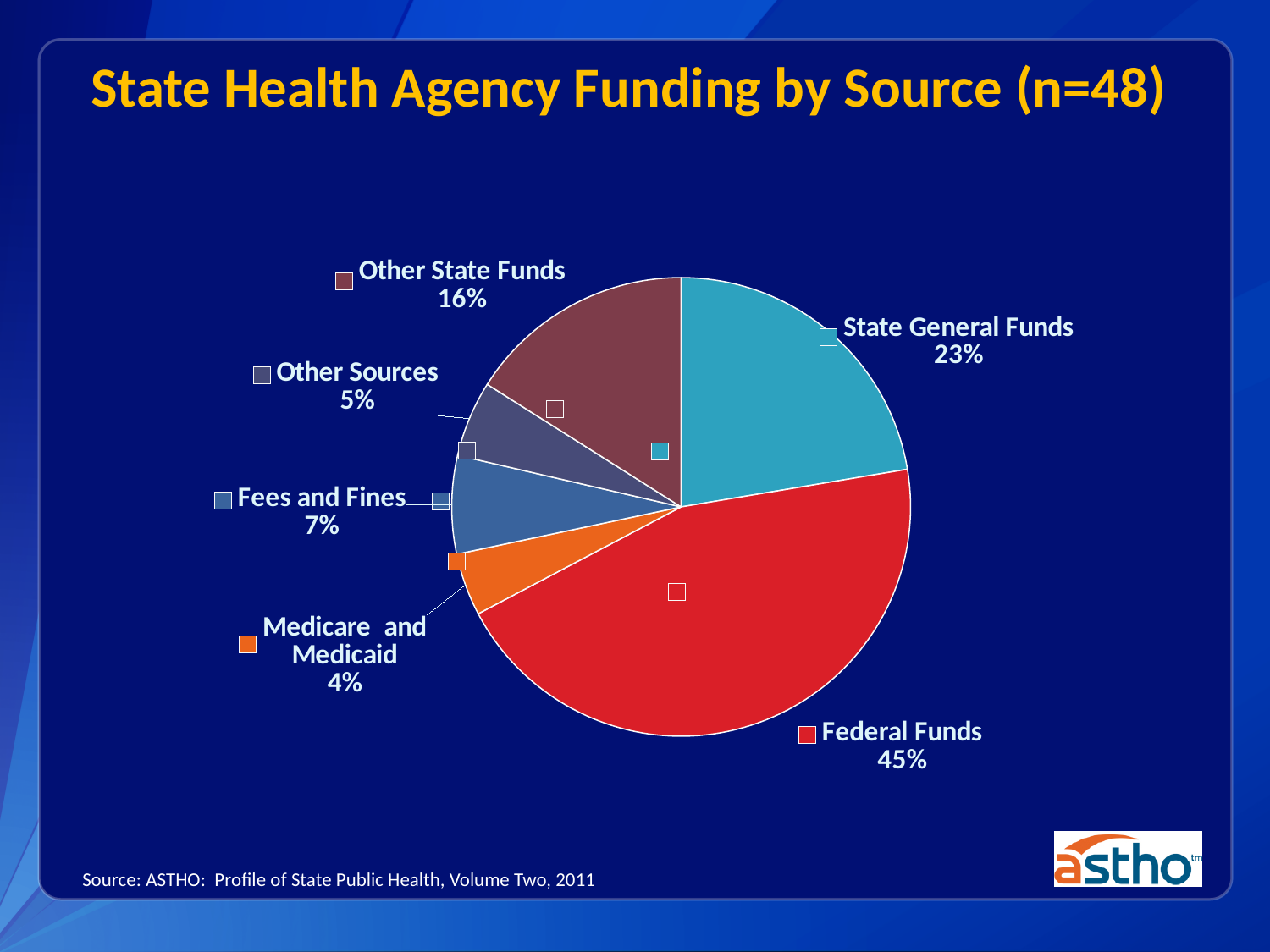
What percentage of funding comes from State General Funds? 23% How many percentage points larger is the Federal Funds share than the State General Funds share? 22 What type of chart is shown on the slide? Pie chart How many funding sources are shown in the pie chart? 6 Which is larger, the share for Fees and Fines or the share for Other Sources? Fees and Fines What is the title of the chart? State Health Agency Funding by Source (n=48) What share of funding is from Medicare and Medicaid? 4% What is the combined share of Other State Funds and Other Sources? 21% Which funding source accounts for the smallest share of the pie? Medicare and Medicaid What share of state health agency funding comes from Federal Funds? 45% Which funding source accounts for the largest share of the pie? Federal Funds What percentage of funding comes from Other State Funds? 16%